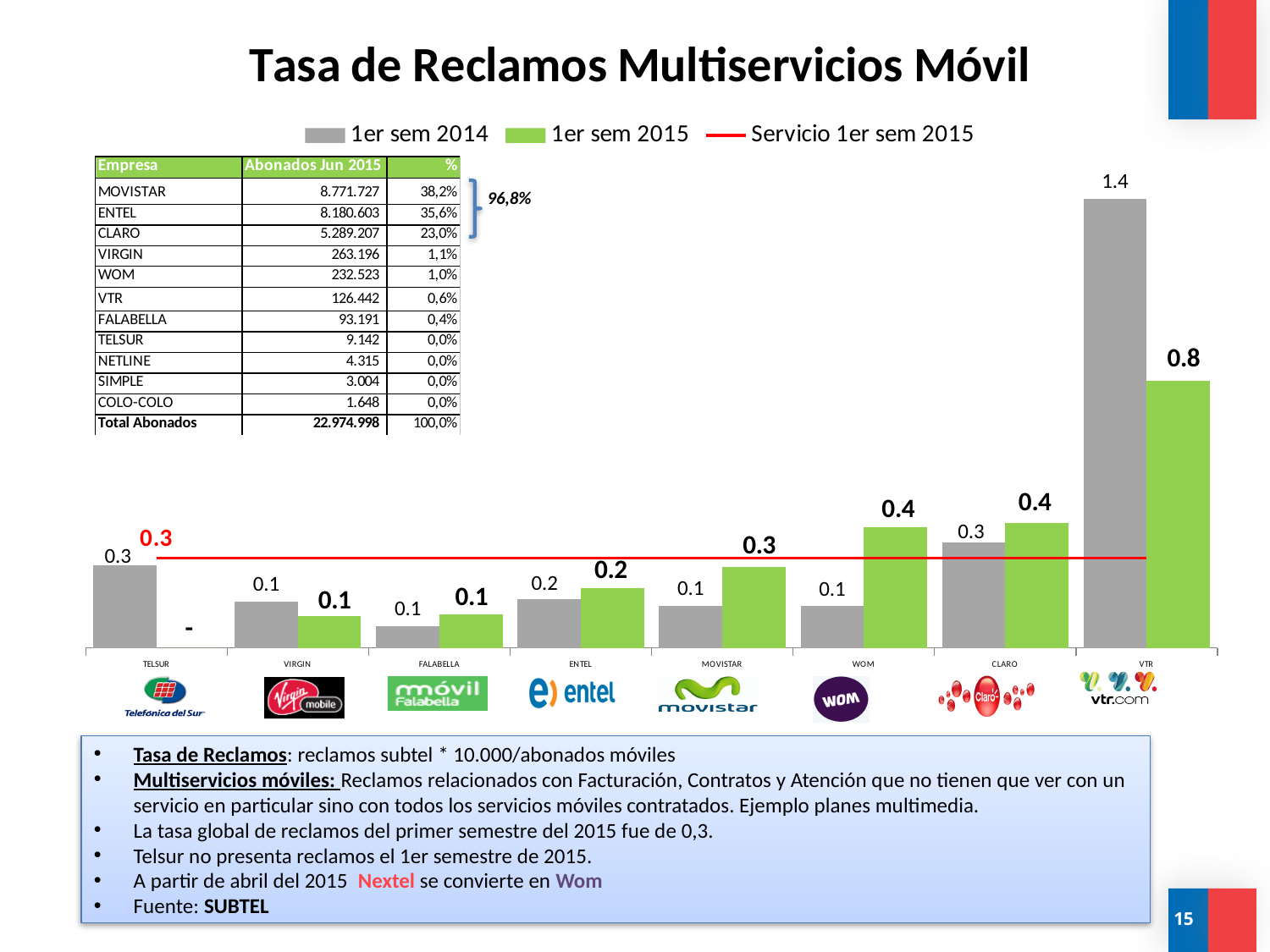
Which company has the highest value in the 1er sem 2014 series? VTR What is the difference between VTR's 1er sem 2014 value and its 1er sem 2015 value? 0.6 What is the value for WOM in the 1er sem 2015 series? 0.4 What kind of chart is shown on the slide? Combination bar and line chart What is the value for ENTEL in the 1er sem 2014 series? 0.2 What is the value for VTR in the 1er sem 2015 series? 0.8 How many companies are shown on the x axis of the chart? 8 How many series does the chart legend list? 3 Which is larger in the 1er sem 2015 series: WOM or MOVISTAR? WOM What is the value for VTR in the 1er sem 2014 series? 1.4 Which company has the highest value in the 1er sem 2015 series? VTR What value does the red 'Servicio 1er sem 2015' line mark on the chart? 0.3